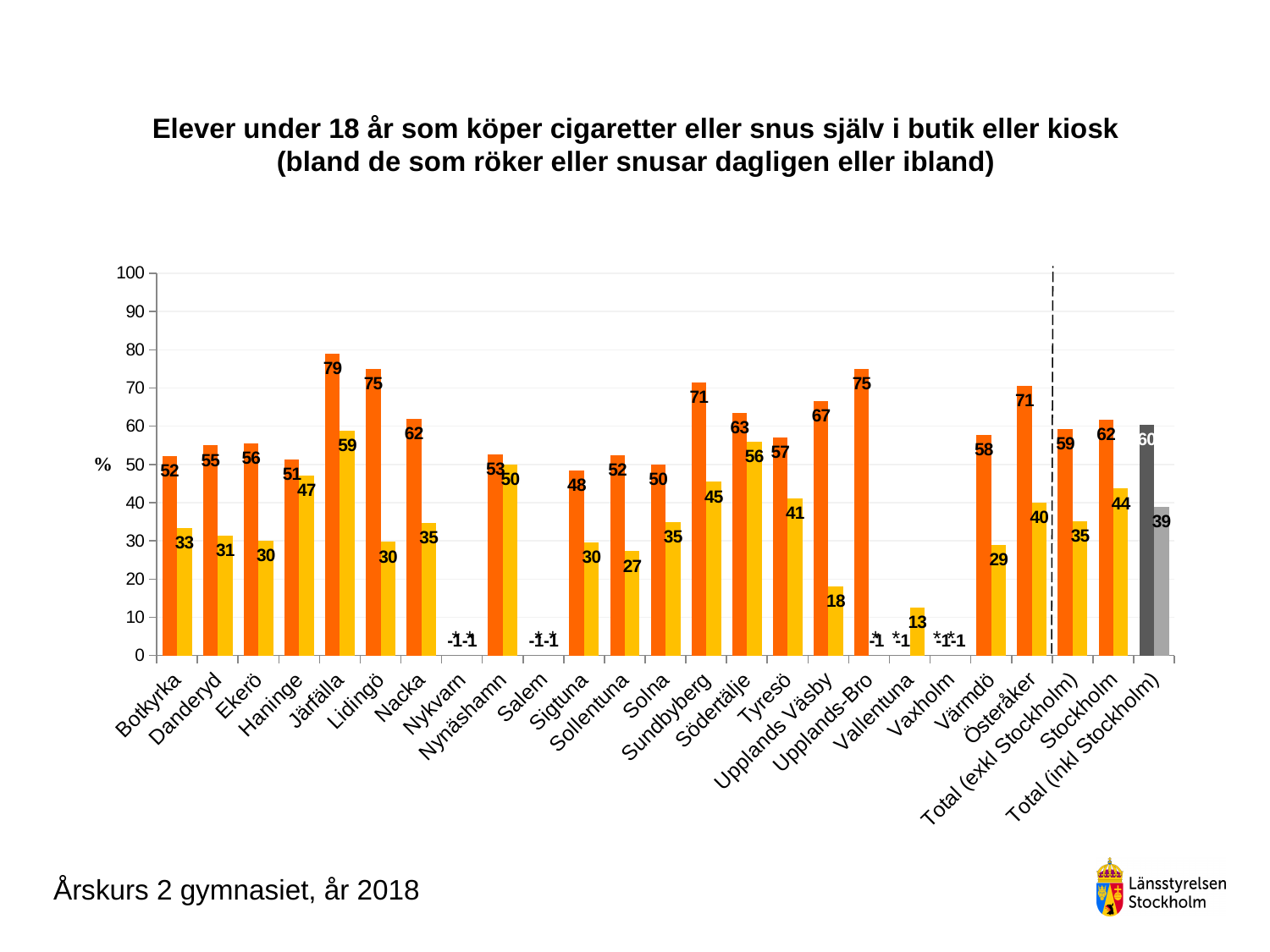
What unit is shown on the y axis label? % Among the yellow bars with a printed value, which municipality has the lowest? Vallentuna Is the value of the orange bar for Nacka greater or less than 50? greater Which municipality has the highest orange bar? Järfälla What is the value of the yellow bar for Stockholm? 44 What is the difference between the orange and yellow bars for Lidingö? 45 What kind of chart is shown on the slide? Bar chart What is the value of the orange bar for Järfälla? 79 Which is larger, the orange bar for Sundbyberg or the orange bar for Upplands Väsby? Sundbyberg How many categories are shown on the x axis? 25 What is the value of the yellow bar for Upplands Väsby? 18